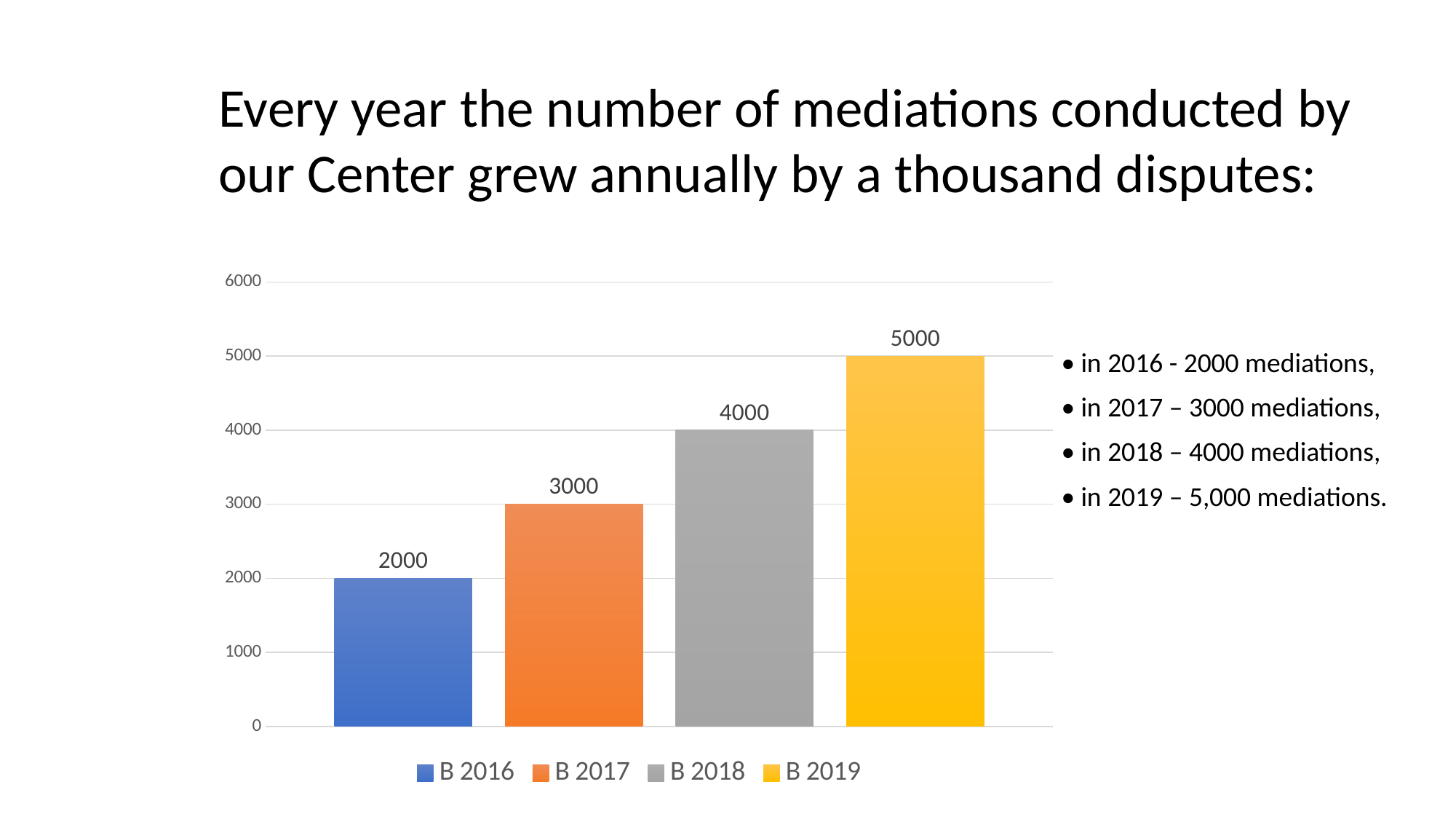
What kind of chart is shown on the slide? bar chart What is the difference between the values for B 2019 and B 2017? 2000 Do the bar values rise or fall from B 2016 to B 2019? rise Which legend entry has the highest bar? B 2019 Which legend entry has the lowest bar? B 2016 What is the value of the bar for B 2019? 5000 Which is larger, the bar for B 2017 or the bar for B 2018? B 2018 What is the value of the bar for B 2018? 4000 What colour is the bar for B 2019? yellow What is the value of the bar for B 2016? 2000 How many bars are plotted in the chart? 4 How many entries does the legend list? 4